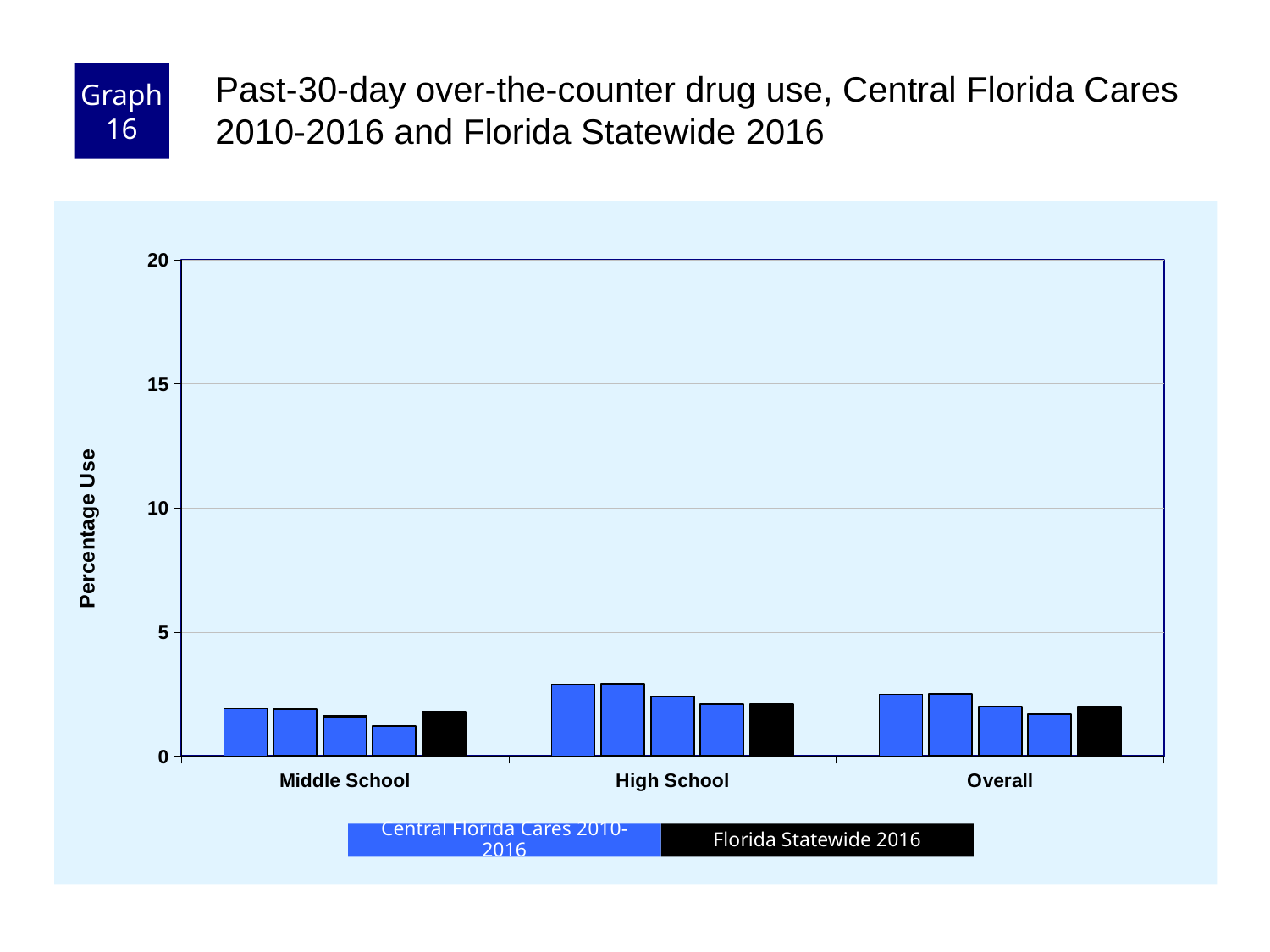
Is the value for Florida Statewide 2016 in the High School category greater or less than 5? less Which colour represents Florida Statewide 2016 in the chart's legend? black Are any of the Central Florida Cares 2010-2016 bars in the High School category greater or less than 5? less What kind of chart is shown on the slide? bar chart Is the value for Florida Statewide 2016 in the Overall category greater or less than 10? less How many series does the chart's legend list? 2 How many categories are shown on the x axis of the chart? 3 What is the label on the vertical axis of the chart? Percentage Use